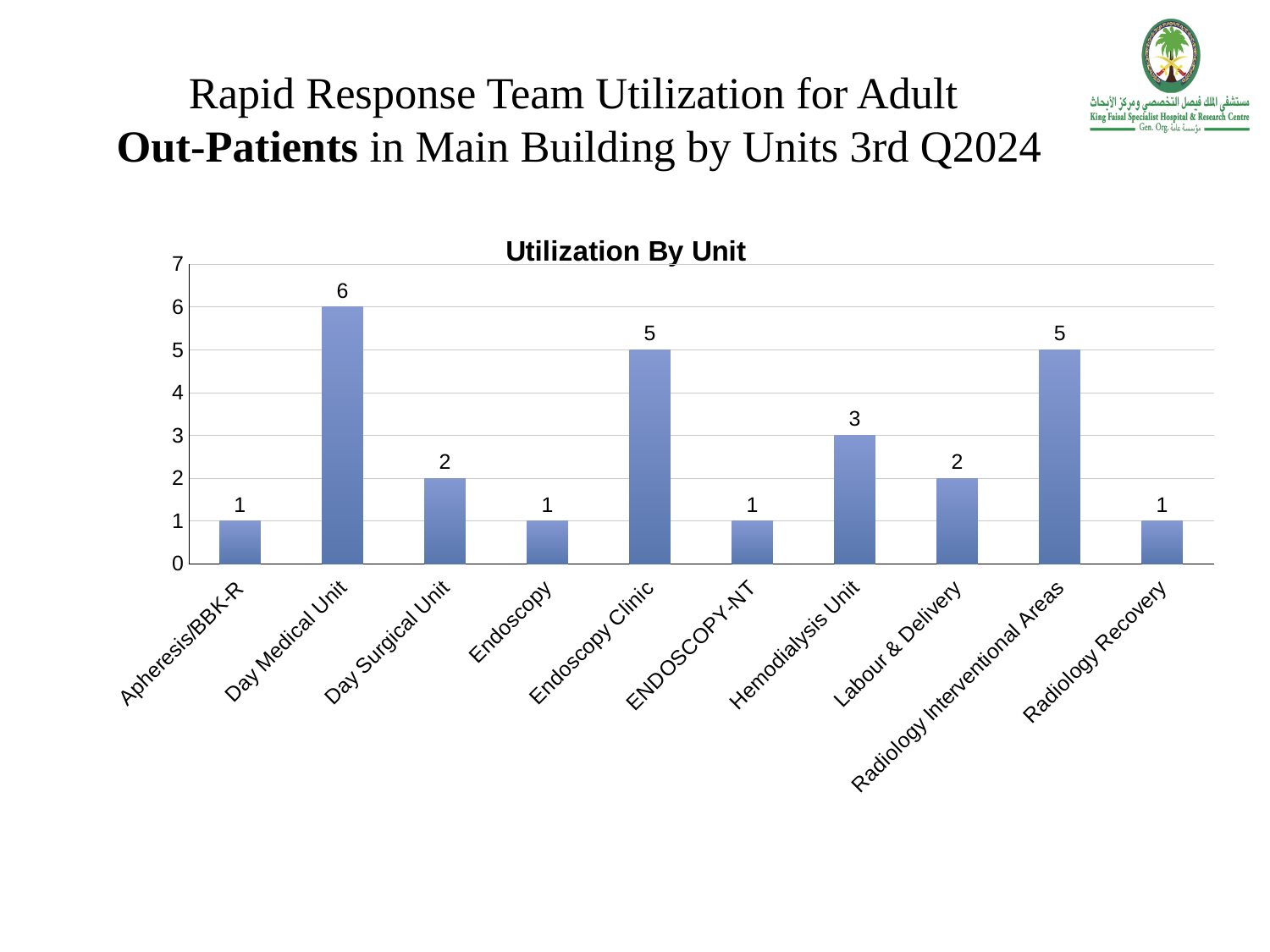
What is the difference between Hemodialysis Unit and Day Surgical Unit? 1 How many units are shown on the x axis? 10 Which unit has the highest value? Day Medical Unit What is the value for Hemodialysis Unit? 3 What is the value for Day Medical Unit? 6 Which is larger, Endoscopy Clinic or Hemodialysis Unit? Endoscopy Clinic What is the value for Radiology Interventional Areas? 5 What is the value for Labour & Delivery? 2 What is the difference between Day Medical Unit and Endoscopy Clinic? 1 What is the title of the chart? Utilization By Unit What kind of chart is this? bar chart Is the value for Day Medical Unit greater or less than 4? greater